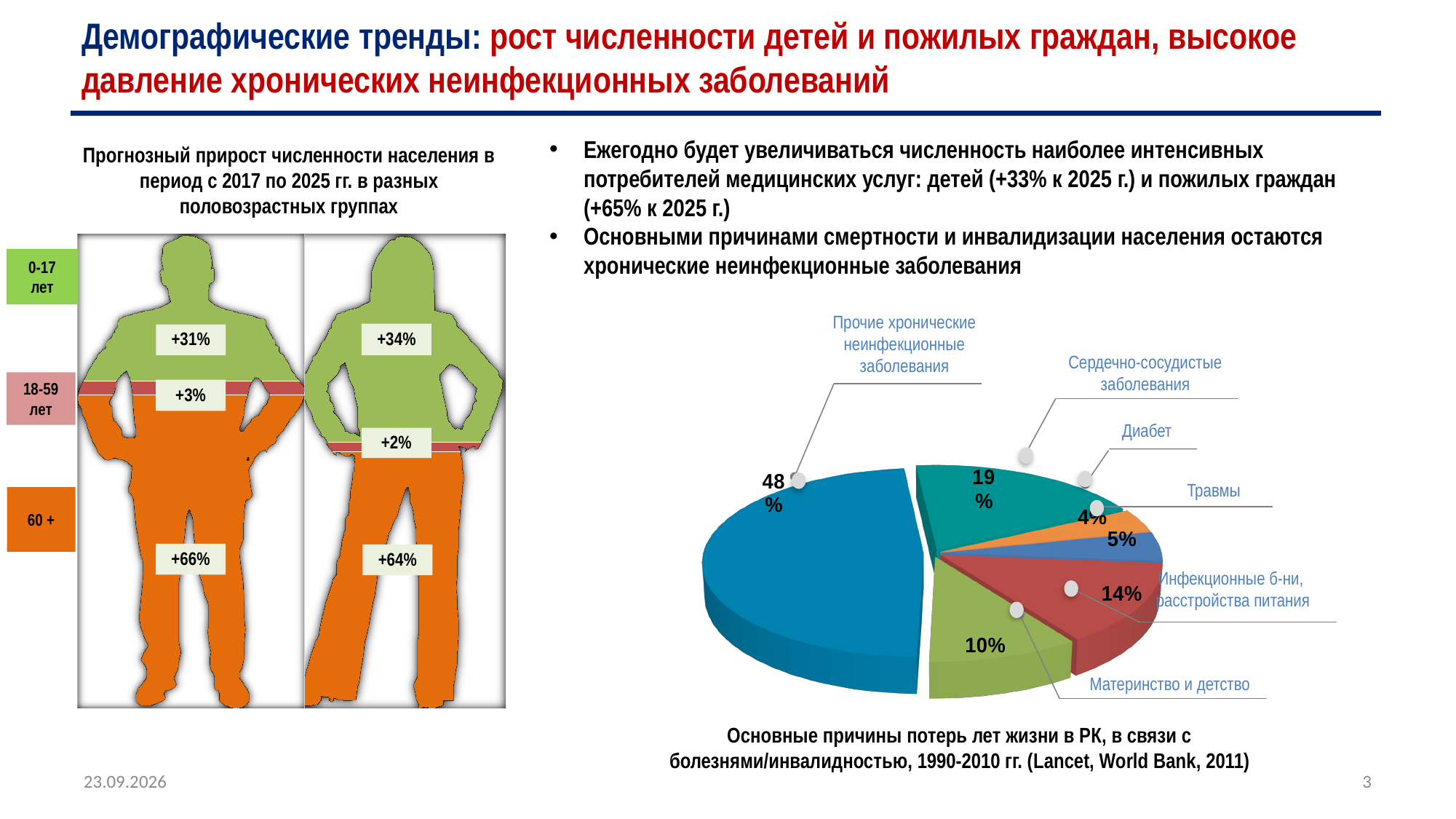
In the population growth figure on the left, what growth is shown for women aged 0-17 лет? +34% In the pie chart on the right, what share is shown for "Диабет"? 4% In the pie chart on the right, what share is shown for "Материнство и детство"? 10% In the pie chart on the right, what share is shown for "Сердечно-сосудистые заболевания"? 19% In the pie chart on the right, how many percentage points larger is "Прочие хронические неинфекционные заболевания" than "Сердечно-сосудистые заболевания"? 29 percentage points In the pie chart on the right, which category has the smallest slice? Диабет What kind of chart is the chart titled "Основные причины потерь лет жизни в РК" on the right of the slide? pie chart In the pie chart on the right, what share is shown for "Инфекционные б-ни, расстройства питания"? 14% In the pie chart on the right, which is larger: "Травмы" or "Диабет"? Травмы In the pie chart on the right, which category has the largest slice? Прочие хронические неинфекционные заболевания In the population growth figure on the left, what growth is shown for men aged 60+? +66% How many slices does the pie chart on the right have? 6